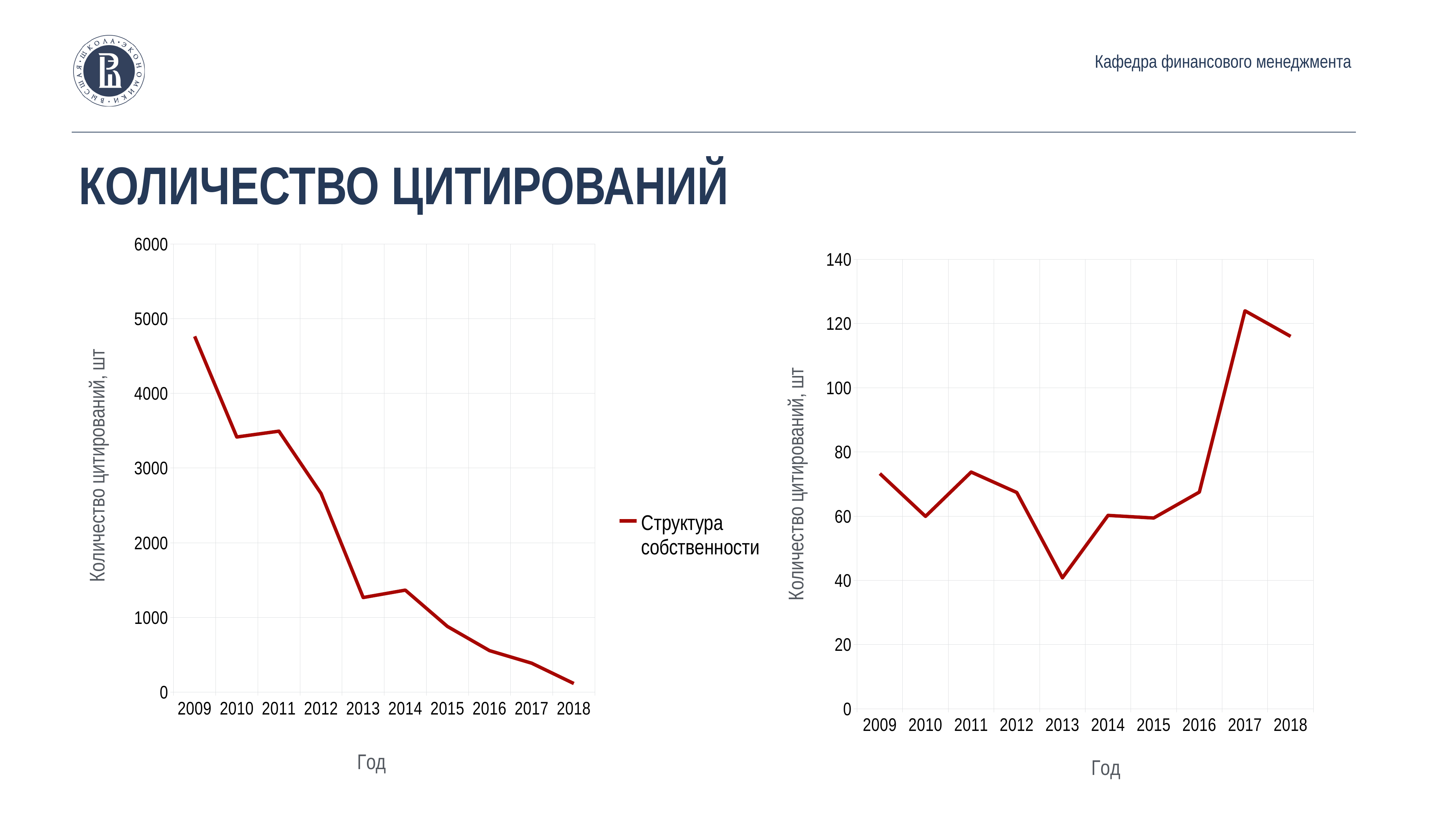
In the left chart, which year has the highest number of citations? 2009 In the left chart, is the value for 2013 greater or less than 2000? less In the left chart, do the values generally rise or fall from 2009 to 2018? fall In the right chart, which year has the highest number of citations? 2017 What kind of chart is the left chart on the slide? line chart In the left chart, which year has the lowest number of citations? 2018 What kind of chart is the right chart on the slide? line chart In the left chart, is the value for 2009 greater or less than 4000? greater What series name does the legend of the left chart list? Структура собственности In the right chart, which year has the lowest number of citations? 2013 In the left chart, how many years are shown on the x axis? 10 In the right chart, is the value for 2017 greater or less than 100? greater